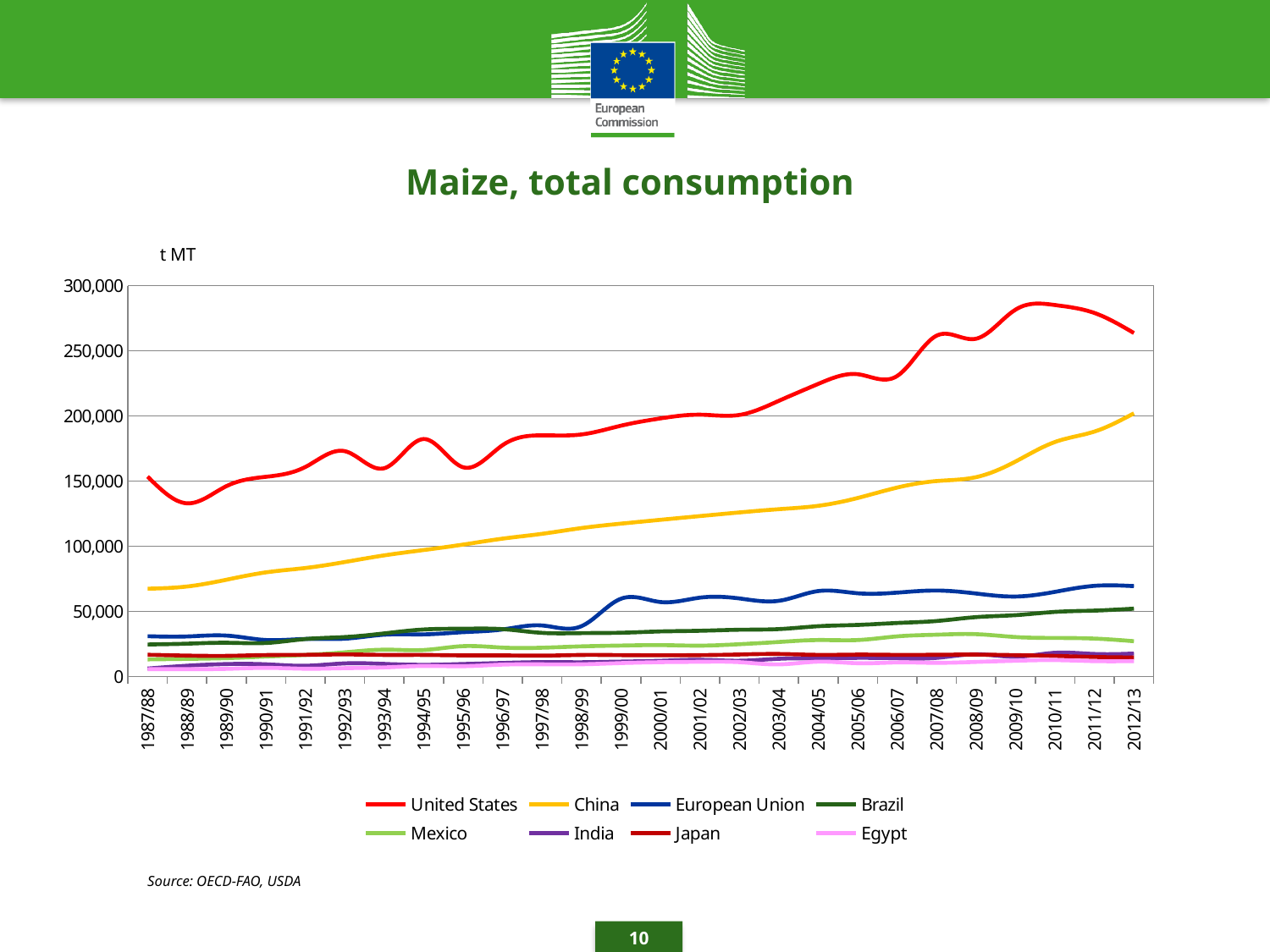
How many marketing years are shown along the x axis? 26 Which country or region has the highest maize consumption in 2012/13? United States Which country has the lowest maize consumption in 2012/13? Egypt Is the value for the United States in 1988/89 greater or less than 150,000? less What kind of chart is shown on the slide? line chart In 2012/13, which is larger: the value for China or the value for the European Union? China Is the value for the European Union in 2012/13 greater or less than 100,000? less What unit is shown above the y axis? t MT Does China's maize consumption rise or fall from 1987/88 to 2012/13? rise Is the value for the United States in 2012/13 greater or less than 250,000? greater How many series does the legend list? 8 What is the title of the chart? Maize, total consumption